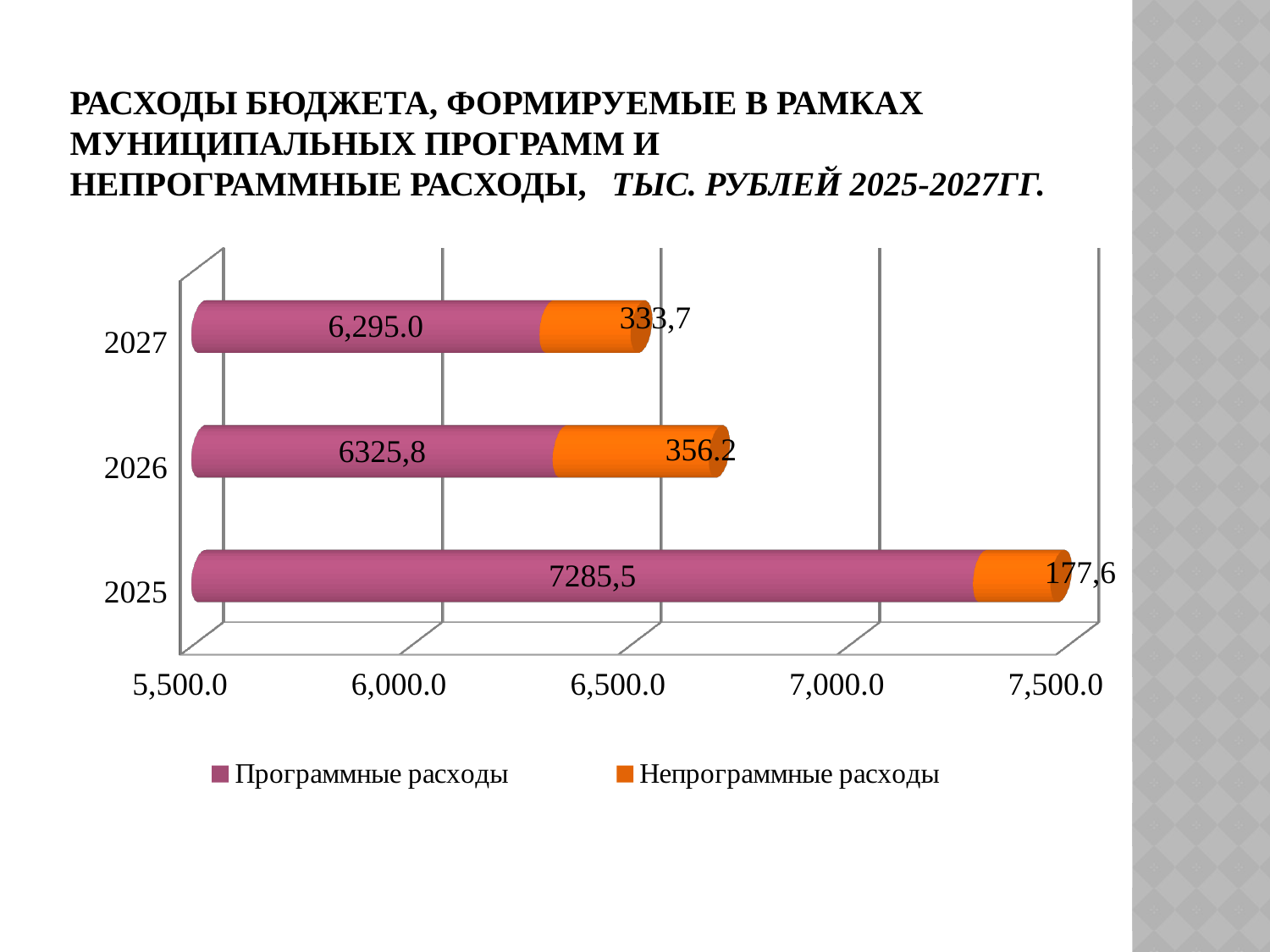
What is the value of Программные расходы for 2027? 6,295.0 How many years (categories) are shown on the chart? 3 What is the value of Программные расходы for 2025? 7285,5 Which year has the highest value of Программные расходы? 2025 What is the value of Непрограммные расходы for 2026? 356.2 What type of chart is shown on the slide? bar chart Which series is shown in orange in the legend? Непрограммные расходы Which is larger: Программные расходы in 2026 or in 2027? 2026 What is the difference between Программные расходы in 2025 and in 2026? 959,7 How many series does the legend list? 2 Which year has the lowest value of Непрограммные расходы? 2025 What is the value of Непрограммные расходы for 2025? 177,6